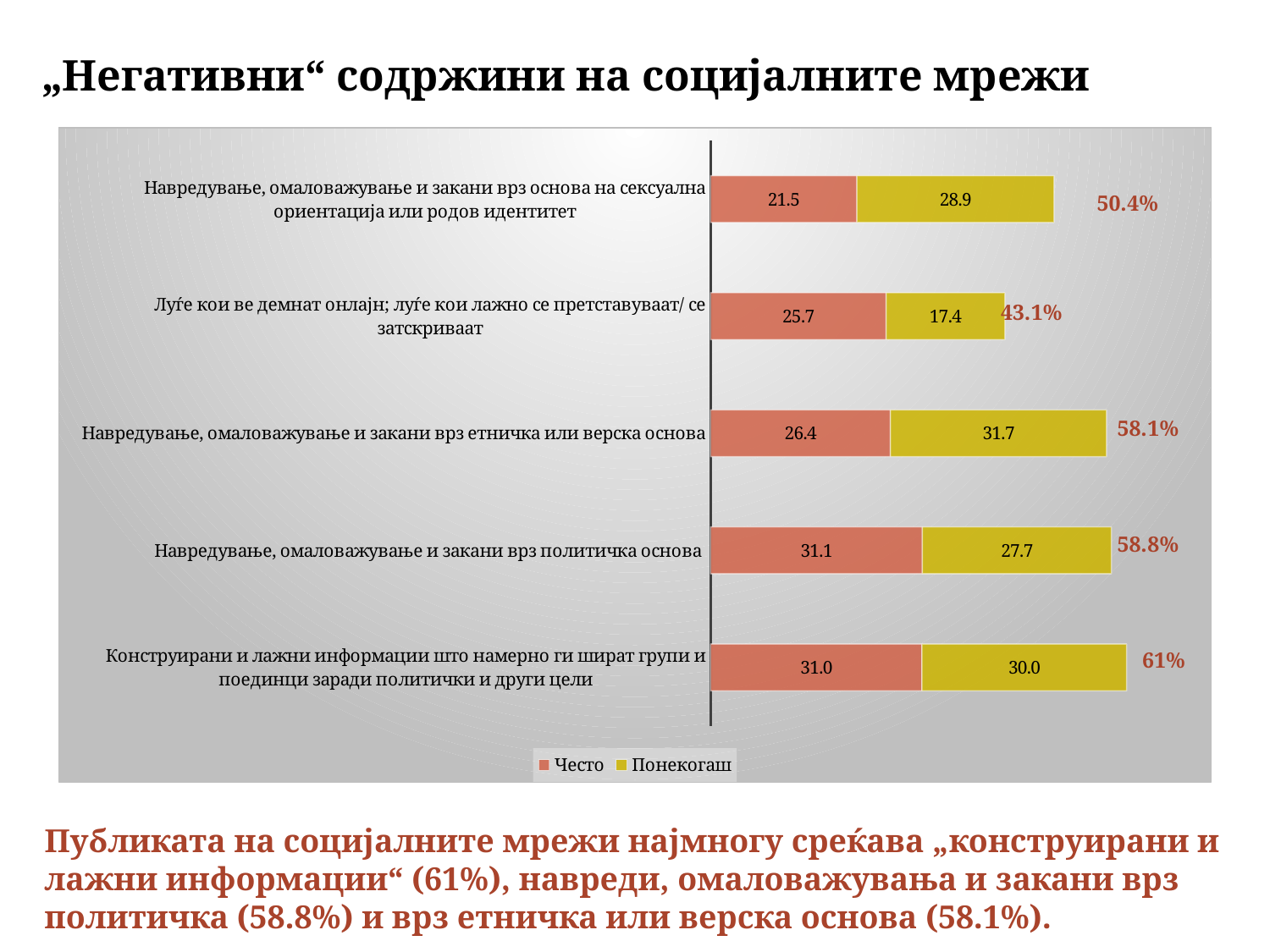
Which category has the lowest printed total? Луѓе кои ве демнат онлајн; луѓе кои лажно се претставуваат/ се затскриваат What is the difference between the 'Понекогаш' value and the 'Често' value for 'Навредување, омаловажување и закани врз основа на сексуална ориентација или родов идентитет'? 7.4 How many categories are plotted in the chart? 5 How many series does the legend list? 2 Which category has the highest printed total? Конструирани и лажни информации што намерно ги шират групи и поединци заради политички и други цели What is the 'Често' value for 'Навредување, омаловажување и закани врз политичка основа'? 31.1 Which is larger for 'Луѓе кои ве демнат онлајн; луѓе кои лажно се претставуваат/ се затскриваат': the 'Често' value or the 'Понекогаш' value? Често What total is printed next to the bar for 'Конструирани и лажни информации што намерно ги шират групи и поединци заради политички и други цели'? 61% What kind of chart is shown on the slide? stacked bar chart What is the 'Понекогаш' value for 'Навредување, омаловажување и закани врз етничка или верска основа'? 31.7 Which series is shown in yellow in the legend? Понекогаш What is the 'Често' value for 'Луѓе кои ве демнат онлајн; луѓе кои лажно се претставуваат/ се затскриваат'? 25.7